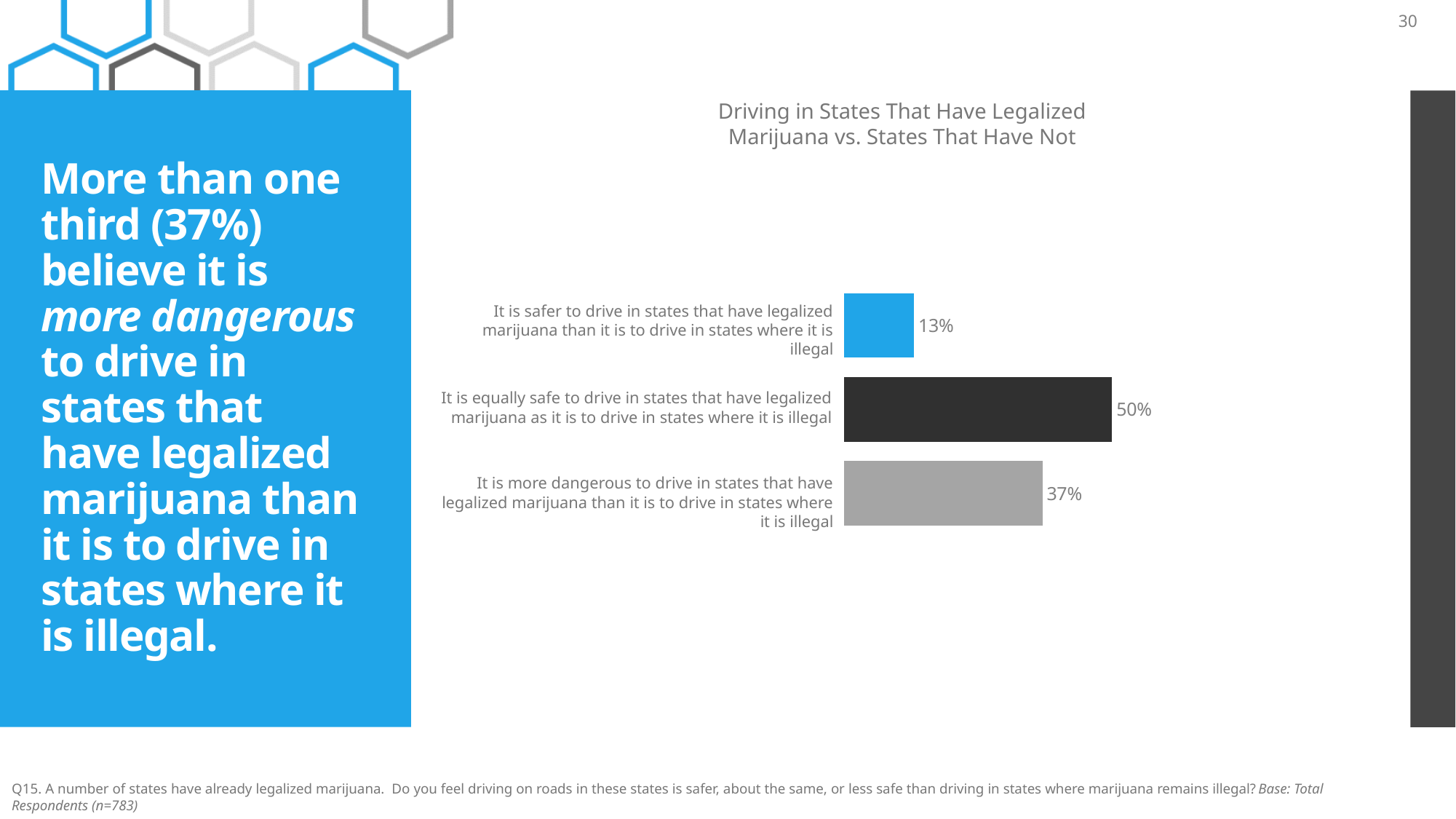
Which is larger: the percentage saying it is more dangerous or the percentage saying it is safer? More dangerous How many response categories are shown in the chart? 3 What percentage of respondents say it is equally safe to drive in states that have legalized marijuana as in states where it is illegal? 50% What percentage of respondents say it is more dangerous to drive in states that have legalized marijuana than in states where it is illegal? 37% What type of chart is shown on the slide? Bar chart What is the difference in percentage points between the 'more dangerous' response and the 'safer' response? 24 What colour is the bar for the 'safer to drive' response? Blue What is the difference in percentage points between the 'equally safe' response and the 'more dangerous' response? 13 Which response has the lowest percentage? It is safer to drive in states that have legalized marijuana than it is to drive in states where it is illegal What is the title of the chart? Driving in States That Have Legalized Marijuana vs. States That Have Not What percentage of respondents say it is safer to drive in states that have legalized marijuana than in states where it is illegal? 13% Which response has the highest percentage? It is equally safe to drive in states that have legalized marijuana as it is to drive in states where it is illegal